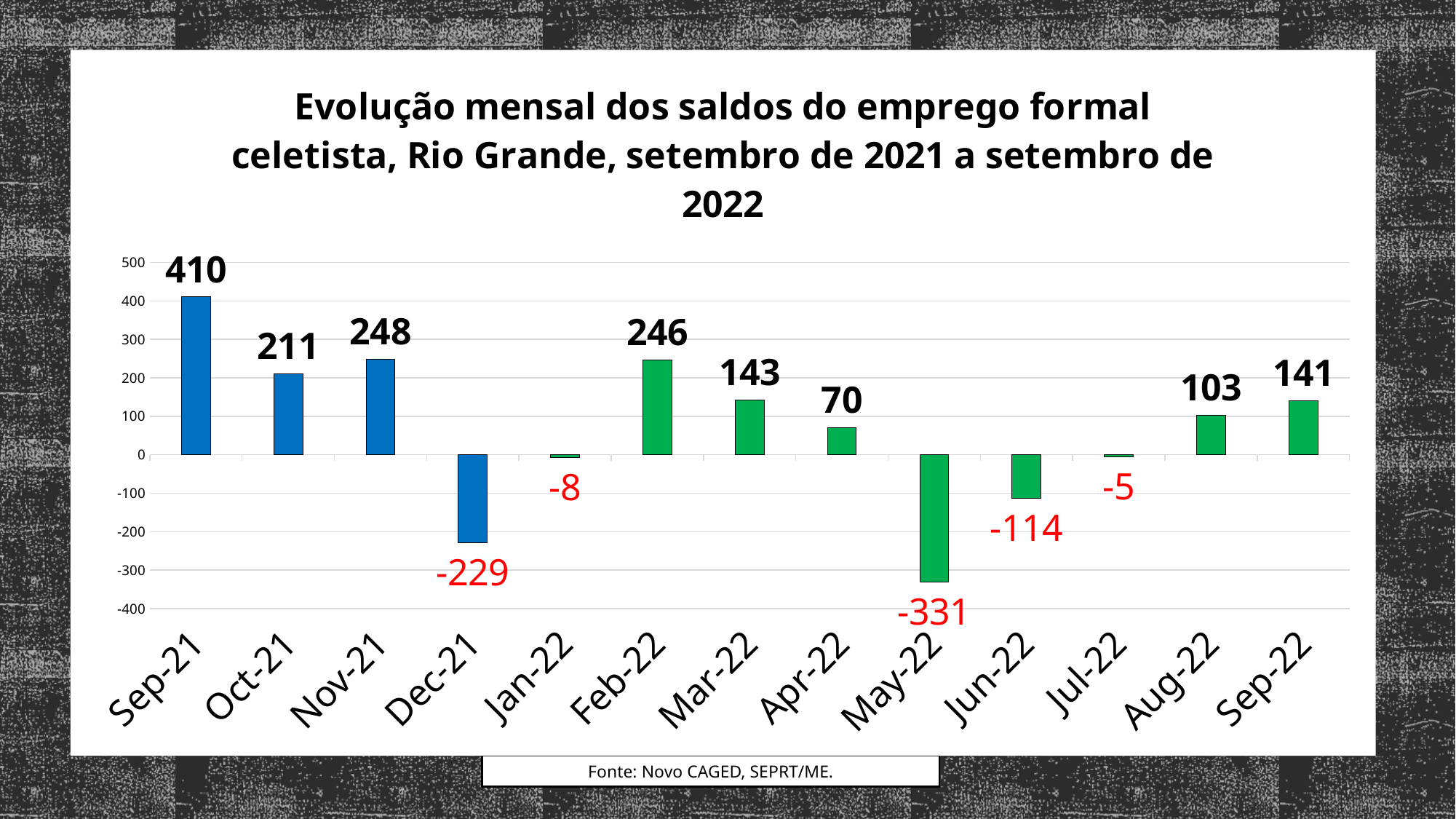
What kind of chart is shown on the slide? bar chart Which month has the highest value? Sep-21 Which month has the lowest value? May-22 Is the value for Dec-21 greater or less than -200? less What is the value for Sep-21? 410 What is the value for May-22? -331 What is the difference between the values for Nov-21 and Oct-21? 37 What is the difference between the values for Sep-22 and Aug-22? 38 How many months are shown on the x axis? 13 Which is larger, the value for Feb-22 or the value for Mar-22? Feb-22 What source is cited below the chart? Novo CAGED, SEPRT/ME. What is the value for Jul-22? -5